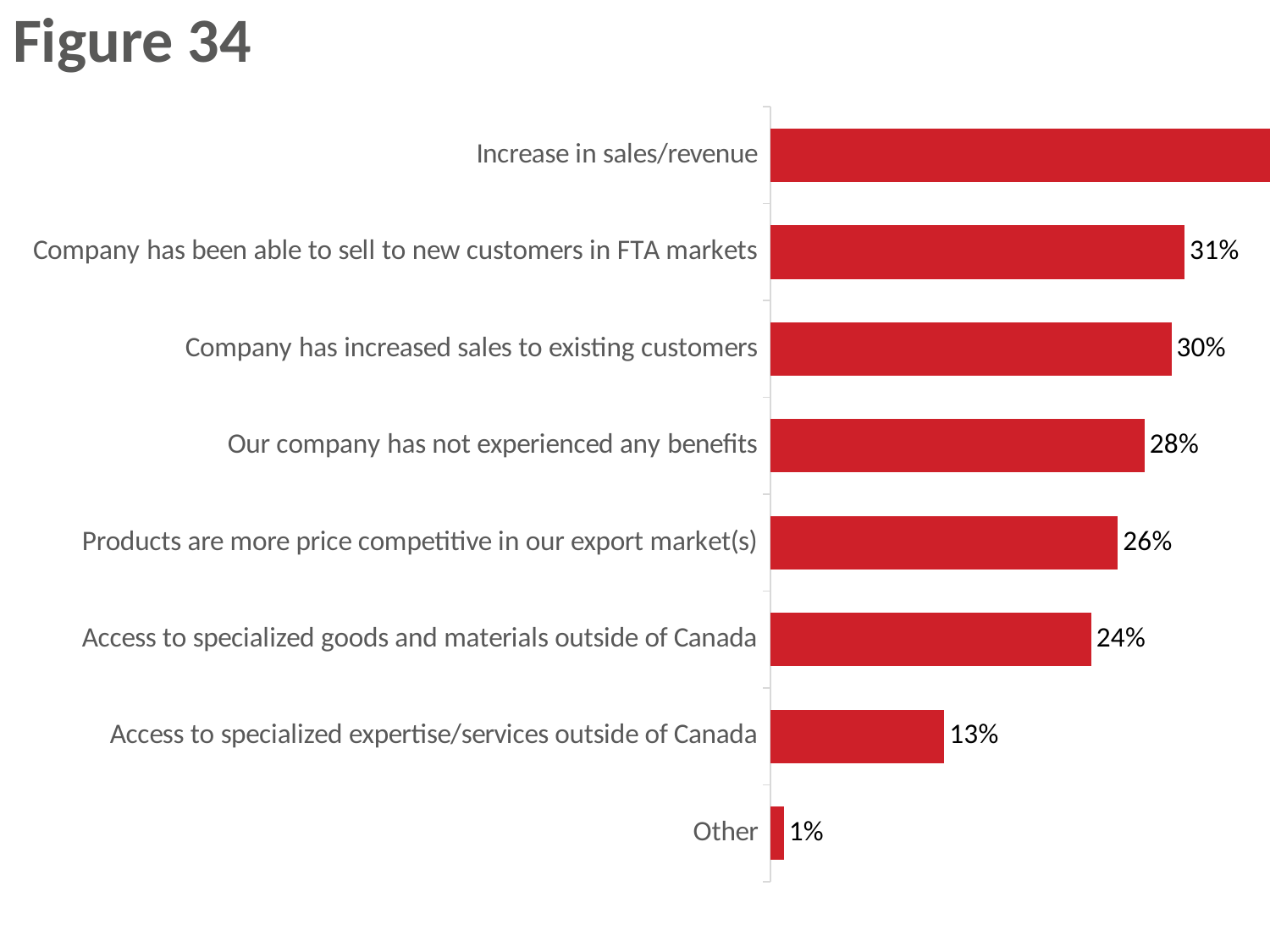
What is the title shown above the chart? Figure 34 Which category has the longest bar in the chart? Increase in sales/revenue Which category has the lowest value in the chart? Other What is the value for "Company has been able to sell to new customers in FTA markets"? 31% What is the value for "Access to specialized expertise/services outside of Canada"? 13% What is the difference between "Products are more price competitive in our export market(s)" and "Access to specialized goods and materials outside of Canada"? 2% Which is larger: the value for "Access to specialized goods and materials outside of Canada" or the value for "Access to specialized expertise/services outside of Canada"? Access to specialized goods and materials outside of Canada How many categories are plotted in the chart? 8 What kind of chart is shown on the slide? bar chart What is the value for "Our company has not experienced any benefits"? 28% What is the difference between "Company has been able to sell to new customers in FTA markets" and "Other"? 30% What is the value for "Company has increased sales to existing customers"? 30%